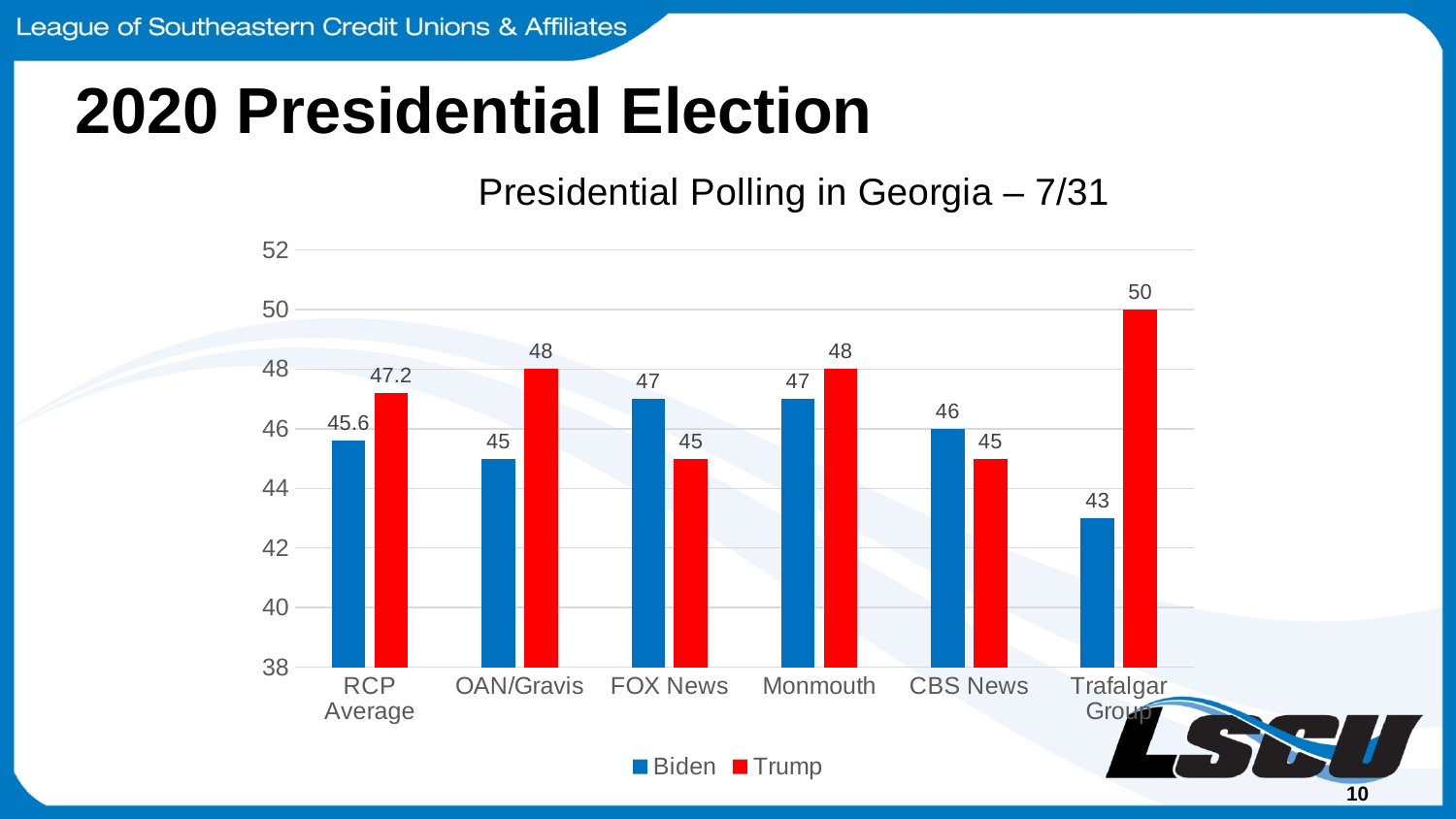
How many series does the legend list? 2 Which poll shows the lowest Biden value? Trafalgar Group What is the difference between the Trump and Biden values in the Trafalgar Group poll? 7 What is the Trump value for the FOX News poll? 45 Which poll shows the highest Trump value? Trafalgar Group In the CBS News poll, which candidate has the higher value, Biden or Trump? Biden What is the Biden value for the RCP Average? 45.6 How many polls (categories) are shown on the x axis? 6 What is the title of the chart? Presidential Polling in Georgia – 7/31 What is the Trump value for the Trafalgar Group poll? 50 What is the difference between the Trump and Biden values in the RCP Average? 1.6 What kind of chart is shown on the slide? Bar chart